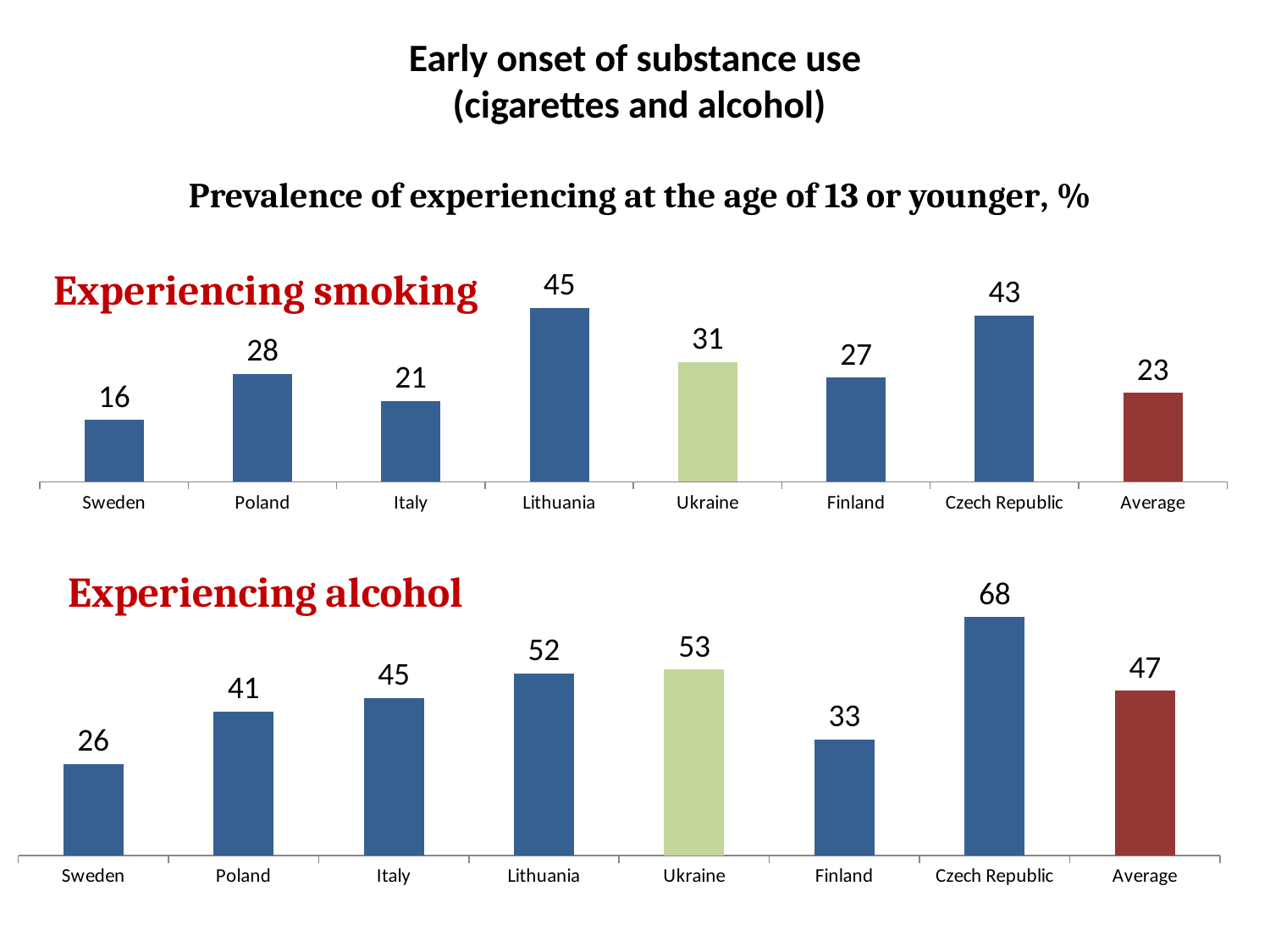
What kind of chart is the 'Experiencing alcohol' chart? Bar chart How many bars are shown in the 'Experiencing smoking' chart? 8 In the 'Experiencing alcohol' chart, which is larger, the value for Ukraine or the value for Lithuania? Ukraine In the 'Experiencing smoking' chart, what is the difference between the values for Czech Republic and Sweden? 27 In the 'Experiencing alcohol' chart, which country has the highest value? Czech Republic In the 'Experiencing smoking' chart, which country has the highest value? Lithuania In the 'Experiencing smoking' chart, what colour is the Average bar? Red In the 'Experiencing smoking' chart, which is larger, the value for Poland or the value for Finland? Poland In the 'Experiencing smoking' chart, what is the value for Ukraine? 31 In the 'Experiencing alcohol' chart, what is the difference between the values for Czech Republic and the Average? 21 In the 'Experiencing alcohol' chart, what is the value for Poland? 41 In the 'Experiencing alcohol' chart, which country has the lowest value? Sweden